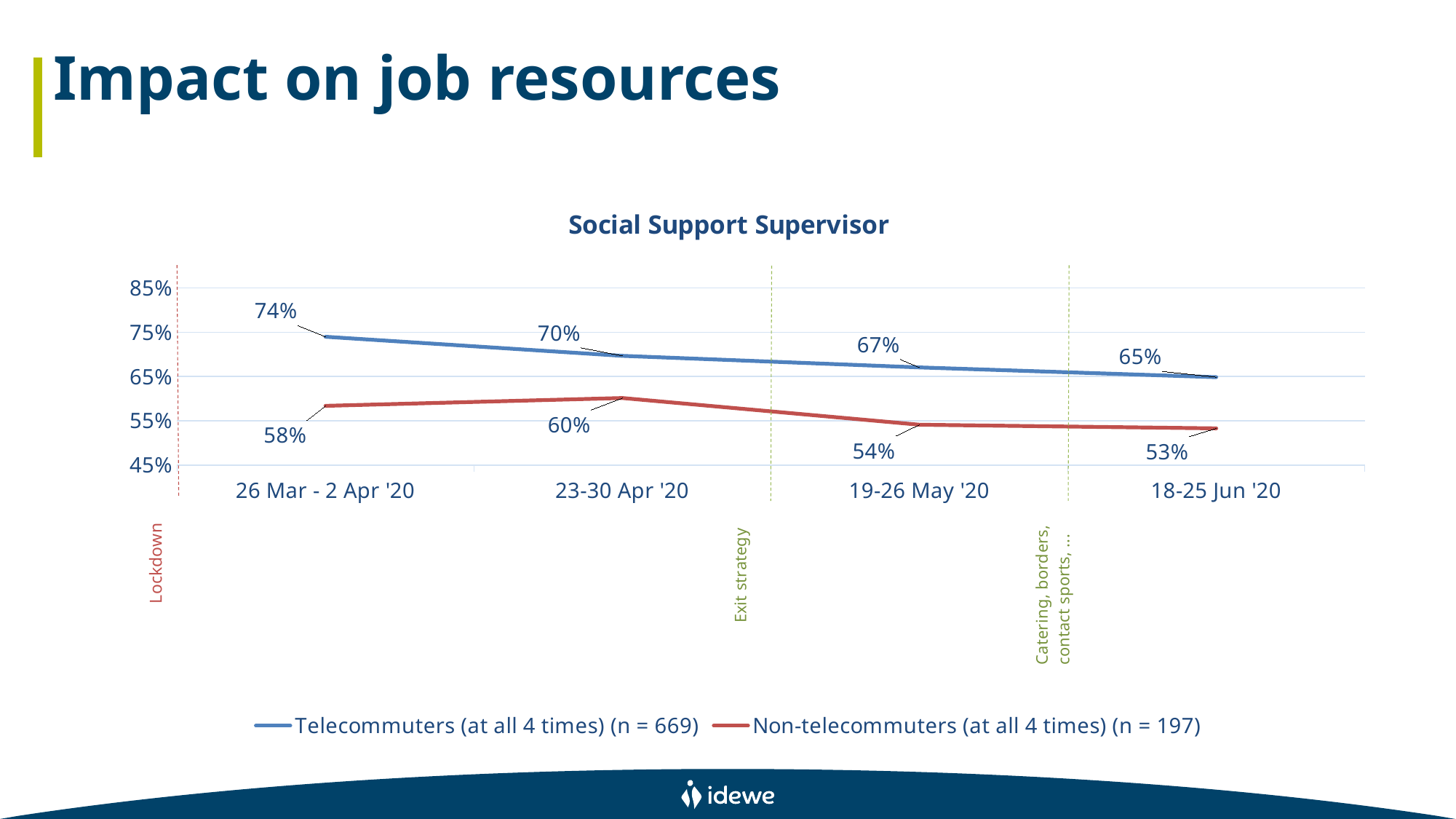
What kind of chart is shown on the slide? Line chart What is the value for Non-telecommuters (at all 4 times) in the 19-26 May '20 period? 54% What is the value for Non-telecommuters (at all 4 times) in the 23-30 Apr '20 period? 60% In which period is the Telecommuters (at all 4 times) value highest? 26 Mar - 2 Apr '20 What is the value for Telecommuters (at all 4 times) in the 26 Mar - 2 Apr '20 period? 74% Which series has the larger value in the 19-26 May '20 period, Telecommuters or Non-telecommuters? Telecommuters (at all 4 times) What is the value for Telecommuters (at all 4 times) in the 18-25 Jun '20 period? 65% What is the difference between the Telecommuters and Non-telecommuters values in the 26 Mar - 2 Apr '20 period? 16% How many series does the legend list? 2 How many time periods are shown on the x axis? 4 In which period is the Non-telecommuters (at all 4 times) value lowest? 18-25 Jun '20 Does the Telecommuters (at all 4 times) series rise or fall across the periods from left to right? Fall